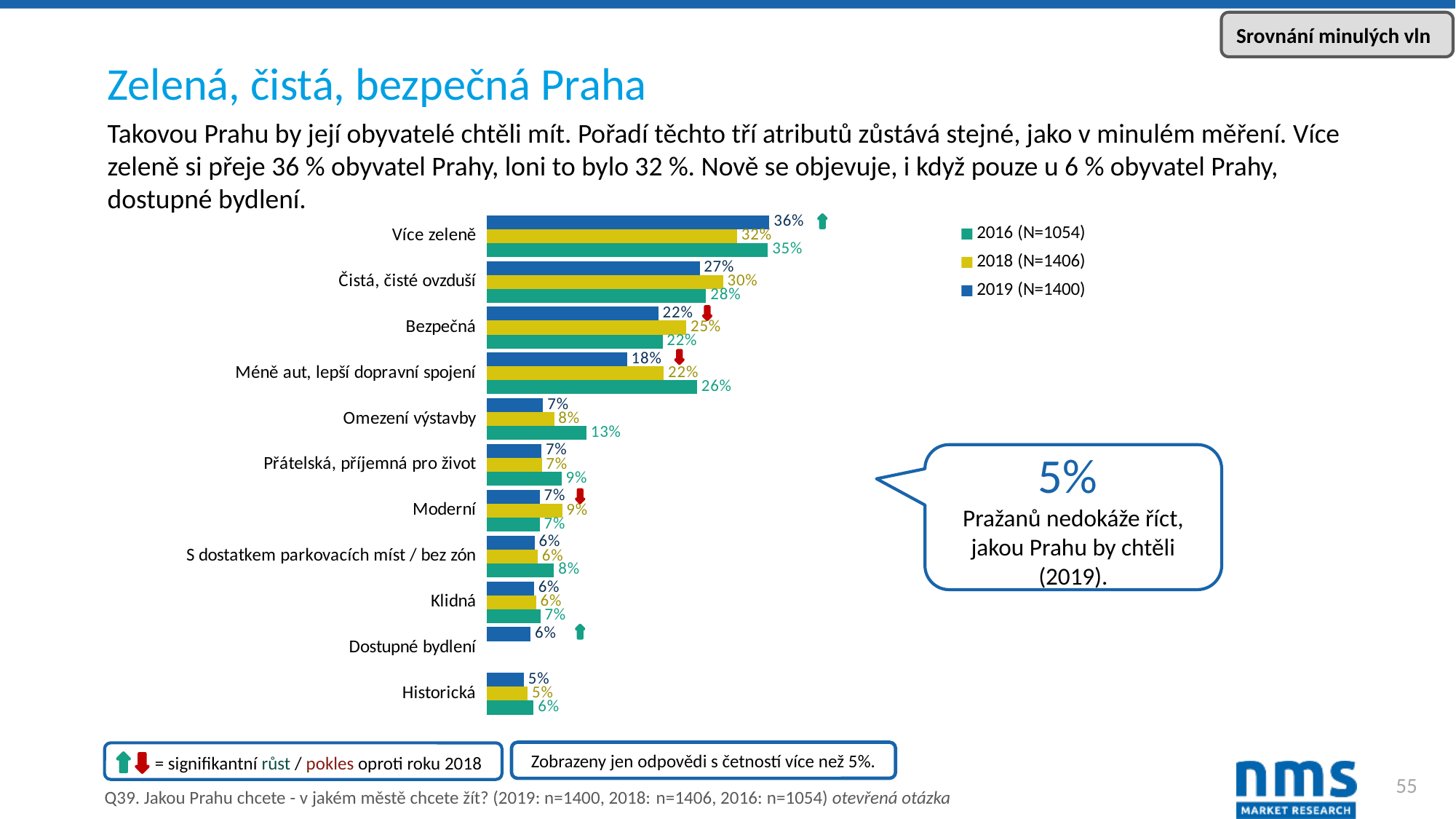
What is the 2019 value for "Více zeleně"? 36% Which category has the lowest 2019 value? Historická What is the difference between the 2016 and 2019 values for "Méně aut, lepší dopravní spojení"? 8 percentage points How many categories are shown in the chart? 11 What is the 2018 value for "Čistá, čisté ovzduší"? 30% What kind of chart is shown on the slide? Bar chart What is the 2016 value for "Omezení výstavby"? 13% What is the 2016 value for "Méně aut, lepší dopravní spojení"? 26% Which is larger for "Bezpečná": the 2018 value or the 2019 value? 2018 Which category has the highest 2019 value? Více zeleně How many series does the legend list? 3 What is the difference between the 2019 and 2018 values for "Více zeleně"? 4 percentage points